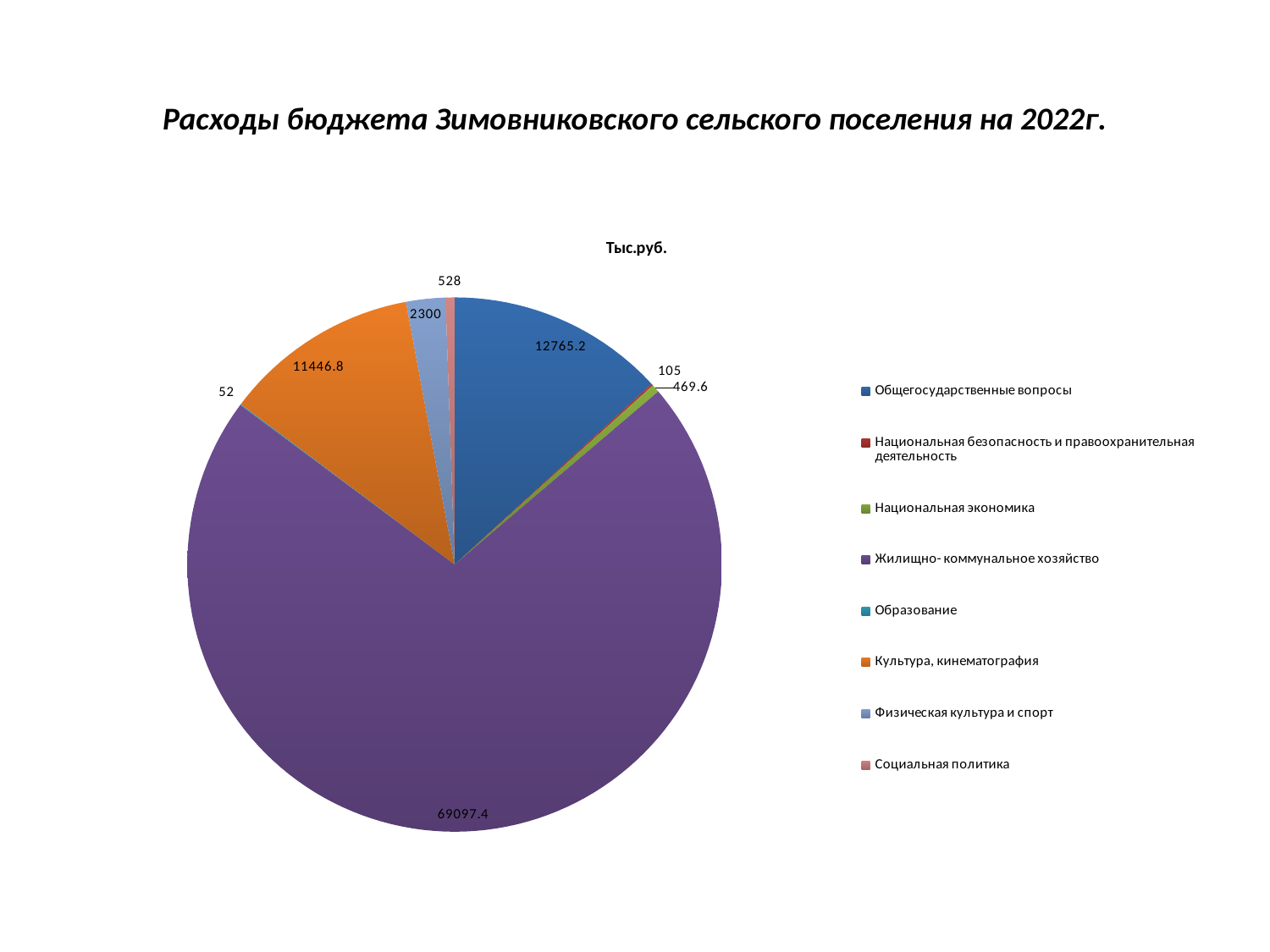
What is the value for Социальная политика? 528 What is the value for Общегосударственные вопросы? 12765.2 What type of chart is shown on the slide? pie chart What is the difference between the values for Общегосударственные вопросы and Культура, кинематография? 1318.4 Which is larger: Национальная экономика or Национальная безопасность и правоохранительная деятельность? Национальная экономика Which category has the largest slice of the pie? Жилищно- коммунальное хозяйство What is the value for Культура, кинематография? 11446.8 What is the value for Физическая культура и спорт? 2300 Which category has the smallest value? Образование What unit is given in the chart title above the pie? Тыс.руб. How many categories does the legend list? 8 What is the value for Жилищно- коммунальное хозяйство? 69097.4